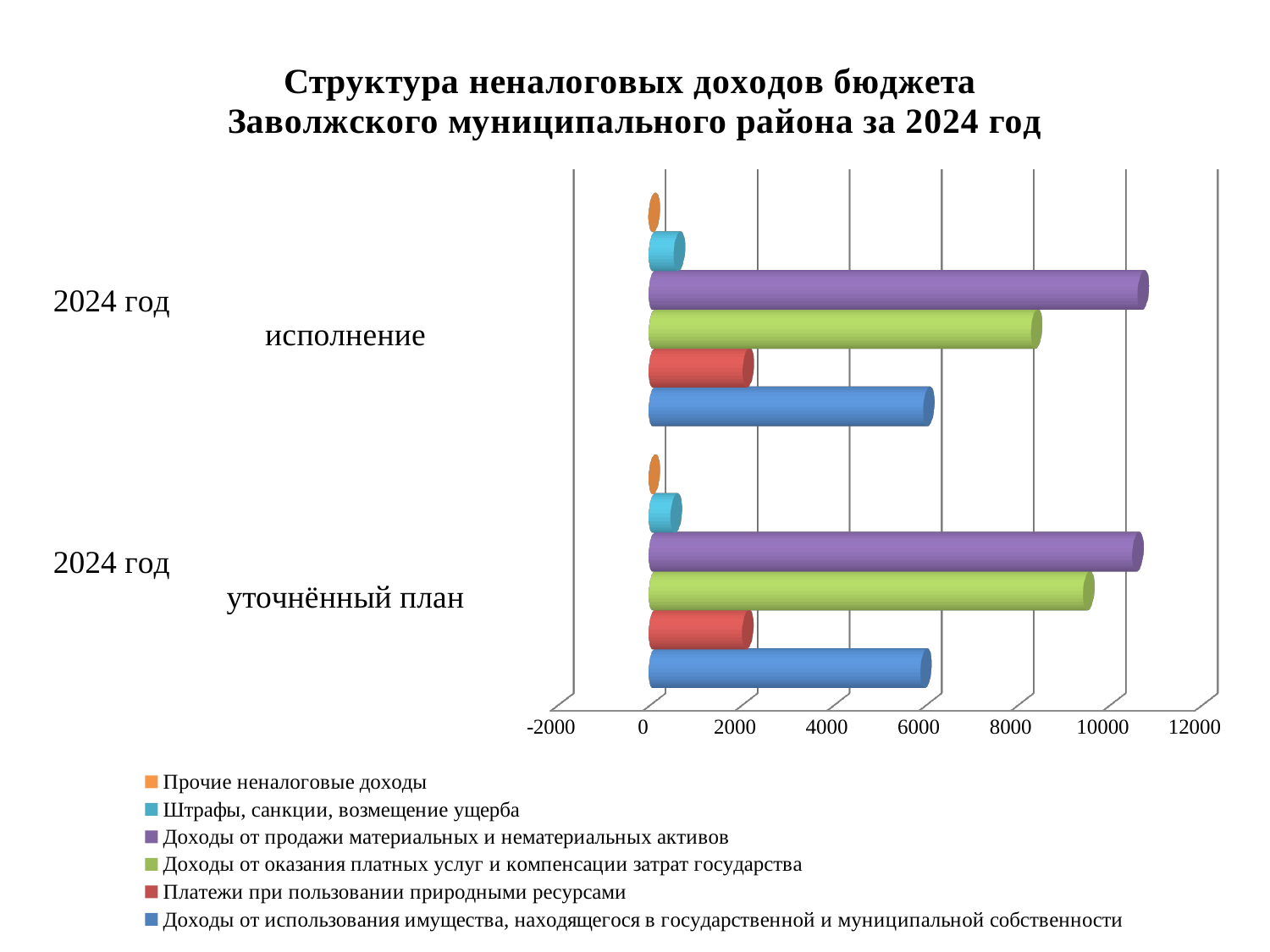
How many categories are shown on the vertical axis? 2 Is the value of "Штрафы, санкции, возмещение ущерба" for "2024 год исполнение" greater or less than 2000? less For "2024 год исполнение", which is larger: "Доходы от продажи материальных и нематериальных активов" or "Доходы от оказания платных услуг и компенсации затрат государства"? Доходы от продажи материальных и нематериальных активов Which series has the highest value for "2024 год исполнение"? Доходы от продажи материальных и нематериальных активов What colour represents "Платежи при пользовании природными ресурсами" in the legend? red What kind of chart is shown on the slide? bar chart Is the value of "Платежи при пользовании природными ресурсами" for "2024 год уточнённый план" greater or less than 4000? less Is the value of "Доходы от продажи материальных и нематериальных активов" for "2024 год исполнение" greater or less than 10000? greater For "Доходы от оказания платных услуг и компенсации затрат государства", which is larger: the value for "2024 год исполнение" or for "2024 год уточнённый план"? 2024 год уточнённый план How many series does the legend list? 6 Which series has the lowest value for "2024 год уточнённый план"? Прочие неналоговые доходы